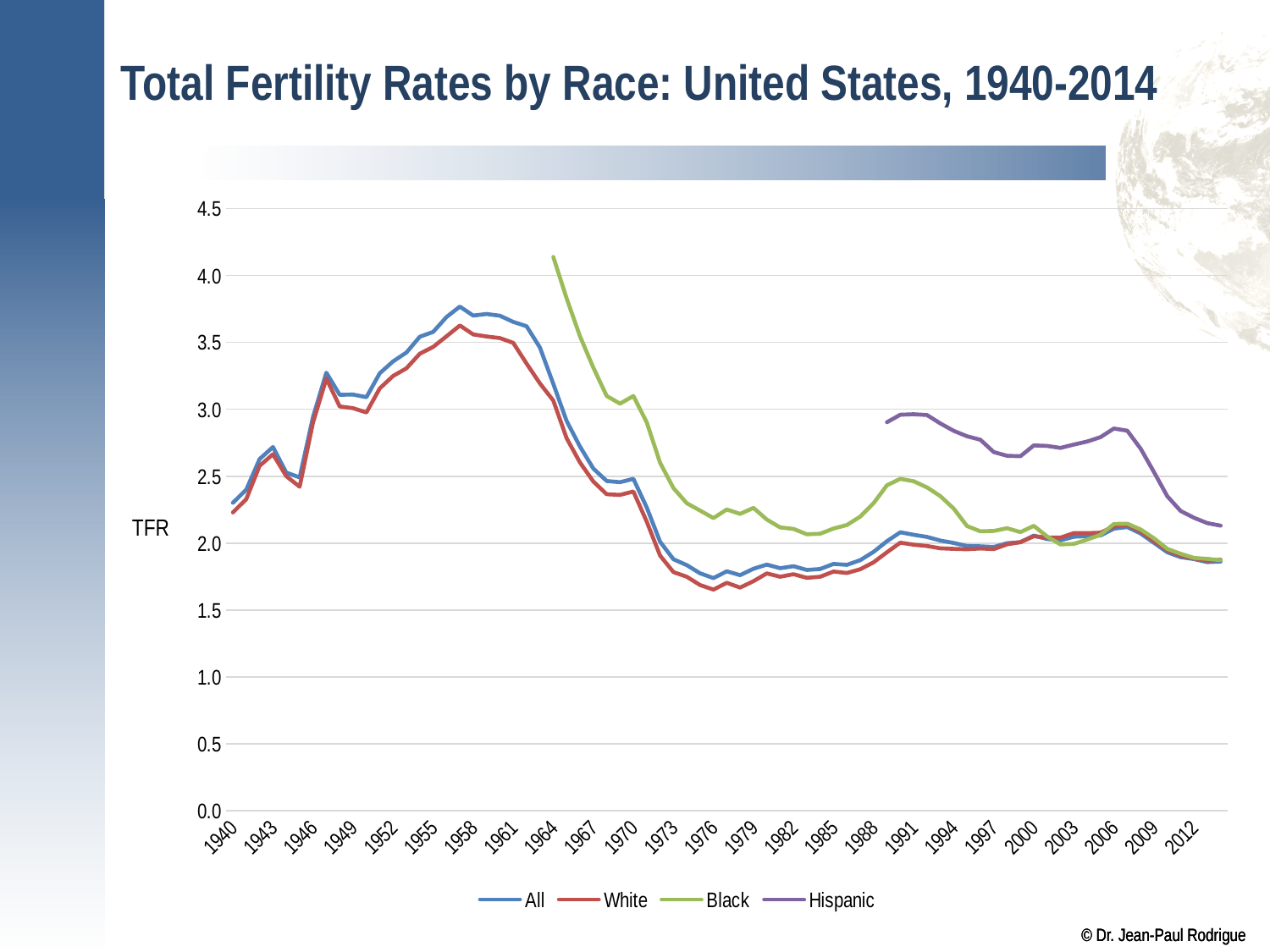
How many series does the legend list? 4 What label is shown on the vertical axis? TFR Is the value for All in 1958 greater or less than 3.5? greater Which series has the highest value in 1991? Hispanic Is the value for Hispanic in 1991 greater or less than 2.5? greater In 1964, which series has the larger value, Black or White? Black What kind of chart is shown on the slide? line chart Is the value for White in 1976 greater or less than 2.0? less Does the Hispanic series rise or fall between 2006 and 2012? fall In 2000, which series has the larger value, Hispanic or All? Hispanic What is the title of the chart? Total Fertility Rates by Race: United States, 1940-2014